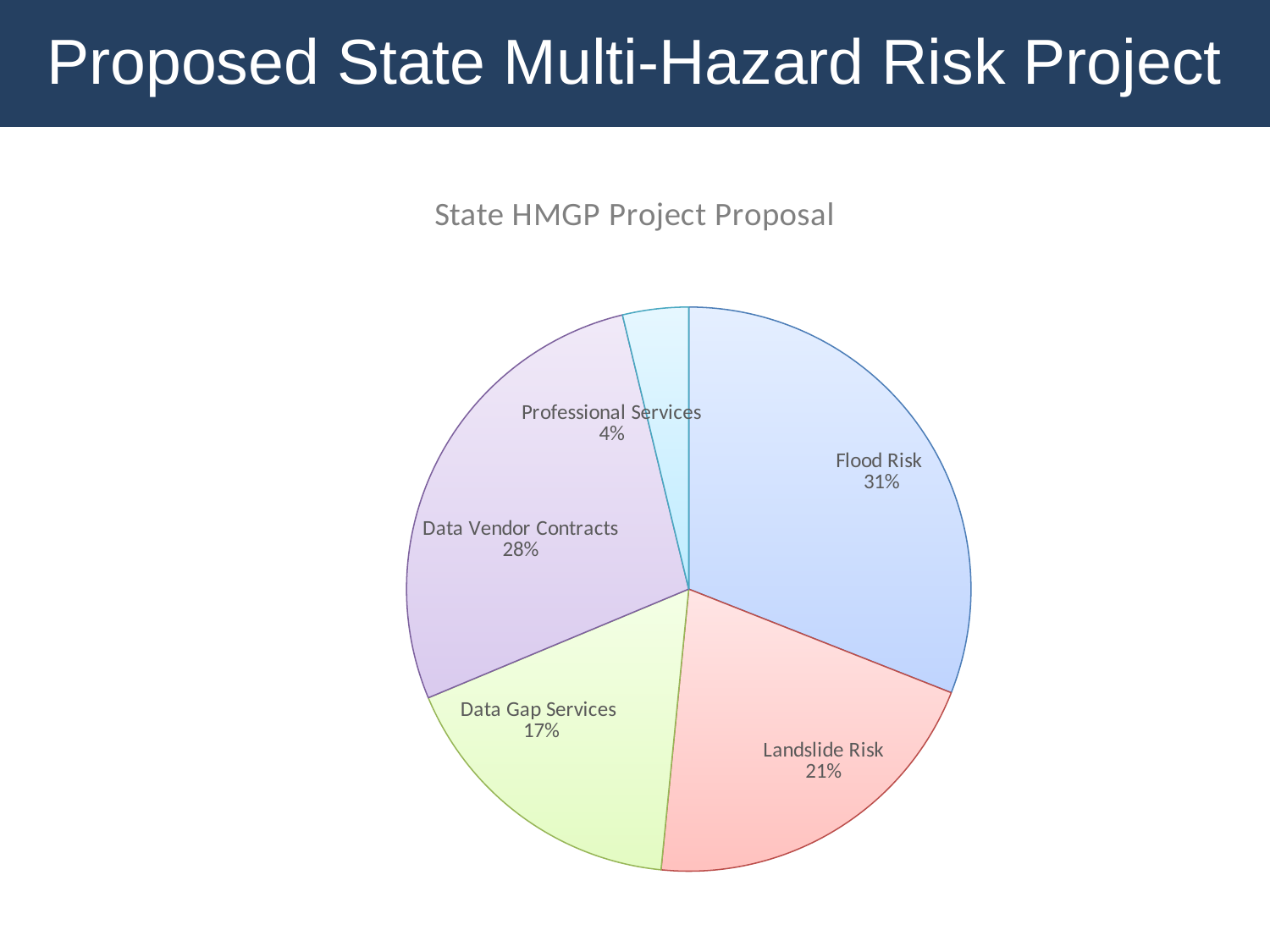
Which category has the largest share of the pie? Flood Risk What percentage is shown for Data Gap Services? 17% Which category has the smallest share of the pie? Professional Services Which is larger, Data Vendor Contracts or Data Gap Services? Data Vendor Contracts What type of chart is shown on the slide? pie chart How many slices does the pie chart have? 5 What percentage is shown for Professional Services? 4% What percentage is shown for Landslide Risk? 21% What share of the pie does Flood Risk represent? 31% What percentage is shown for Data Vendor Contracts? 28% What is the difference in percentage points between Flood Risk and Landslide Risk? 10 What is the title of the chart? State HMGP Project Proposal